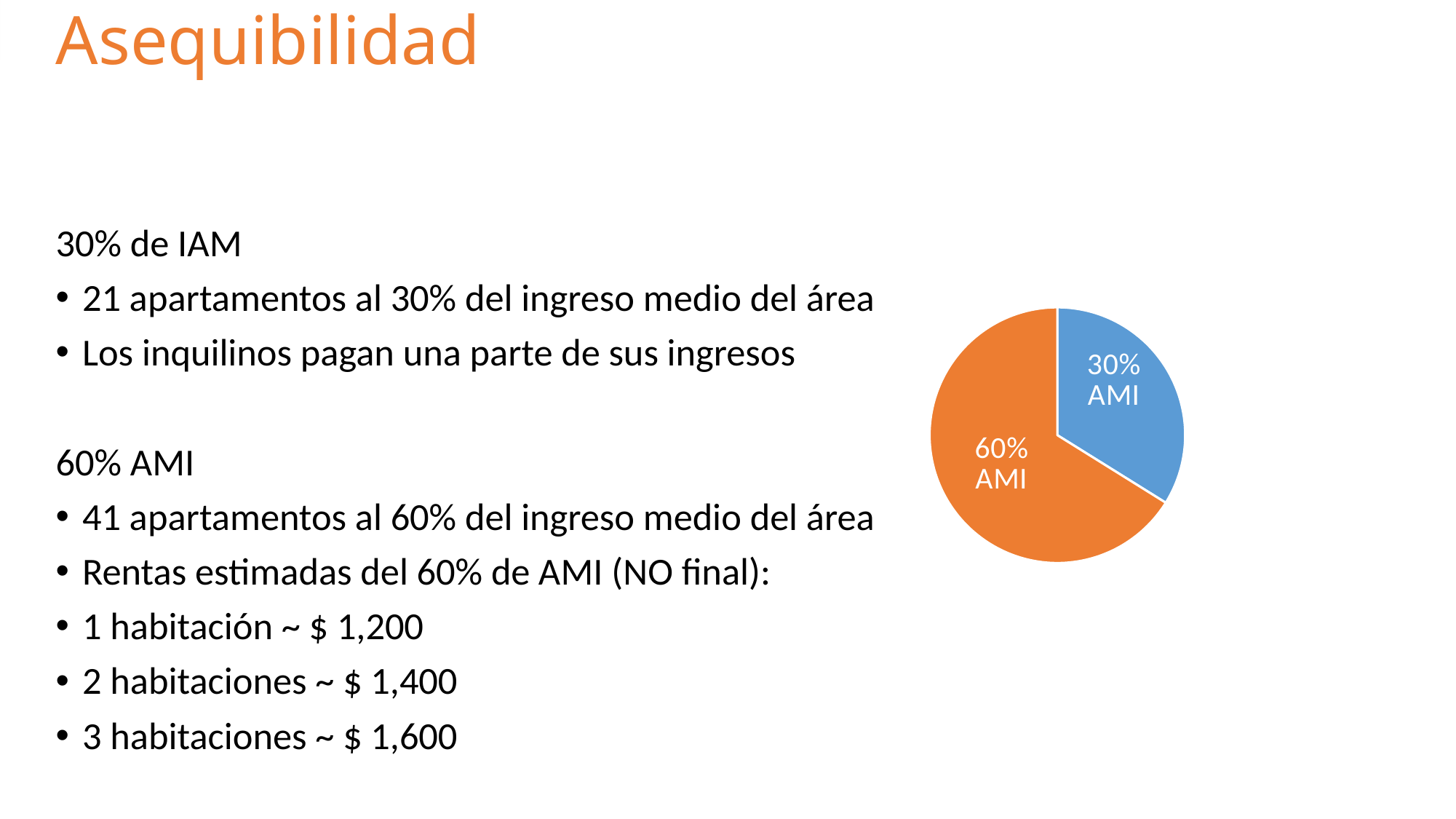
Which slice is larger in the pie chart, 30% AMI or 60% AMI? 60% AMI Which slice of the pie chart is the smallest? 30% AMI Which slice of the pie chart is the largest? 60% AMI What colour is the 30% AMI slice in the pie chart? blue Is the 30% AMI slice greater or less than half of the pie? less Is the 60% AMI slice greater or less than half of the pie? greater What kind of chart is shown on the slide? pie chart How many slices does the pie chart have? 2 What are the labels of the two slices in the pie chart? 30% AMI and 60% AMI